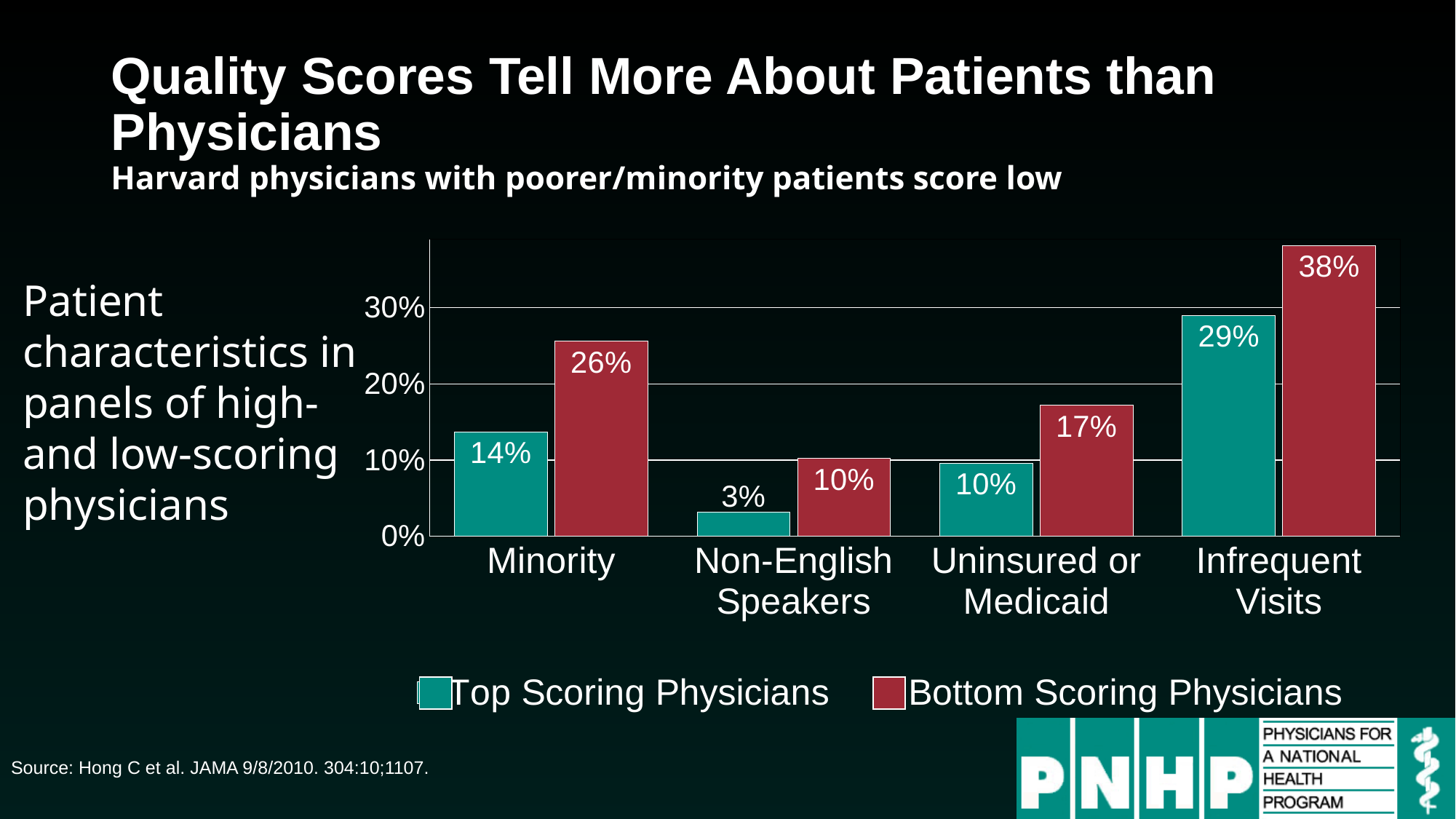
Which category has the highest value for Bottom Scoring Physicians? Infrequent Visits How many series does the legend list? 2 How many categories are shown on the x axis? 4 What kind of chart is shown on the slide? Bar chart What is the value for Top Scoring Physicians in the Non-English Speakers category? 3% What is the value for Top Scoring Physicians in the Minority category? 14% What is the difference between Bottom Scoring Physicians and Top Scoring Physicians in the Minority category? 12% Which category has the lowest value for Top Scoring Physicians? Non-English Speakers What is the value for Bottom Scoring Physicians in the Uninsured or Medicaid category? 17% Which is larger in the Uninsured or Medicaid category: Top Scoring Physicians or Bottom Scoring Physicians? Bottom Scoring Physicians What colour are the bars for Bottom Scoring Physicians? Red What is the value for Bottom Scoring Physicians in the Infrequent Visits category? 38%